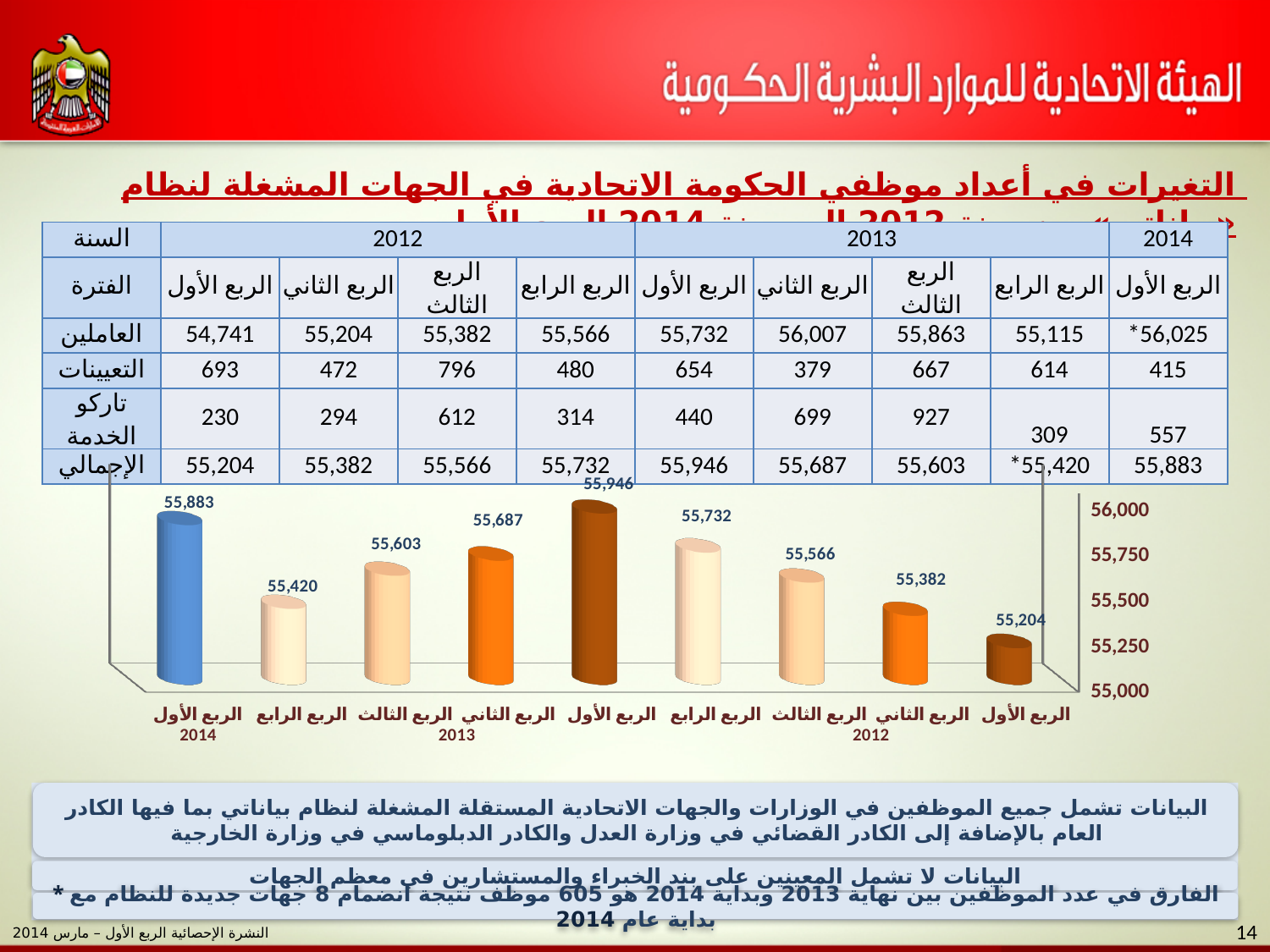
What type of chart is shown on the slide? bar chart How many bars (quarters) are plotted in the chart? 9 What is the difference between the values for الربع الأول 2013 and الربع الرابع 2013 in the chart? 526 What is the value shown for الربع الرابع 2013 in the chart? 55,420 What is the value shown for الربع الأول 2014 in the chart? 55,883 What is the lowest value shown on the chart's vertical axis? 55,000 Which quarter has the highest value in the chart? الربع الأول 2013 Is the value for الربع الرابع 2012 in the chart greater or less than 55,500? greater Which quarter has the lowest value in the chart? الربع الأول 2012 Which is larger in the chart: the value for الربع الثاني 2013 or the value for الربع الثالث 2013? الربع الثاني 2013 Do the values in the chart rise or fall from الربع الأول 2012 to الربع الأول 2013? rise What is the value shown for الربع الأول 2012 in the chart? 55,204